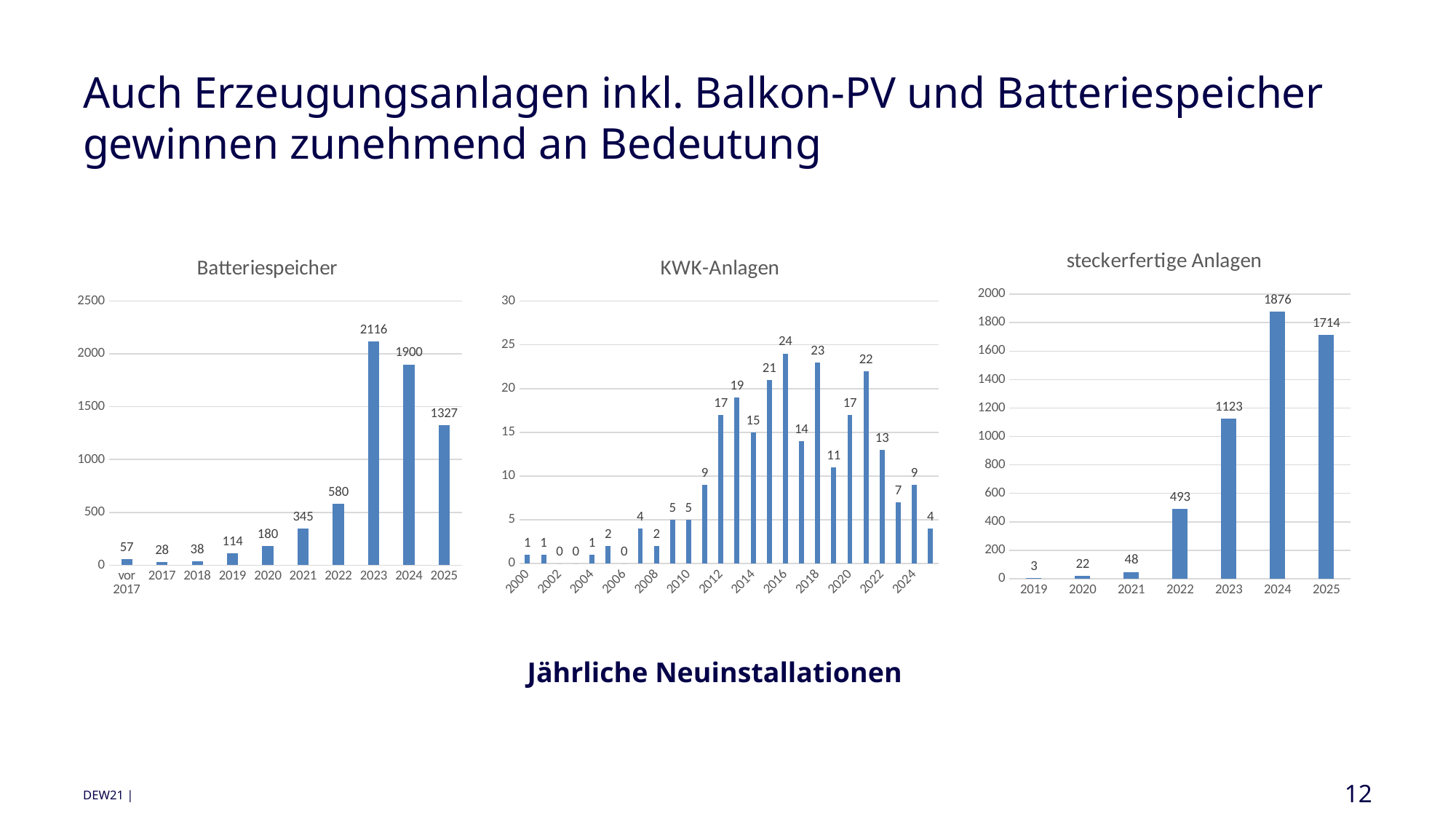
In the steckerfertige Anlagen chart, how many years are shown? 7 In the Batteriespeicher chart, which year has the highest value? 2023 In the Batteriespeicher chart, what is the value for 2023? 2116 In the KWK-Anlagen chart, what is the value for 2018? 23 What type of chart is the steckerfertige Anlagen chart? Bar chart In the steckerfertige Anlagen chart, what is the value for 2024? 1876 In the Batteriespeicher chart, what is the difference between the values for 2024 and 2025? 573 In the steckerfertige Anlagen chart, what is the difference between the values for 2024 and 2025? 162 In the KWK-Anlagen chart, which is larger, the value for 2020 or the value for 2022? 2020 In the Batteriespeicher chart, how many bars are shown? 10 In the steckerfertige Anlagen chart, which year has the lowest value? 2019 In the KWK-Anlagen chart, what is the highest value shown? 24